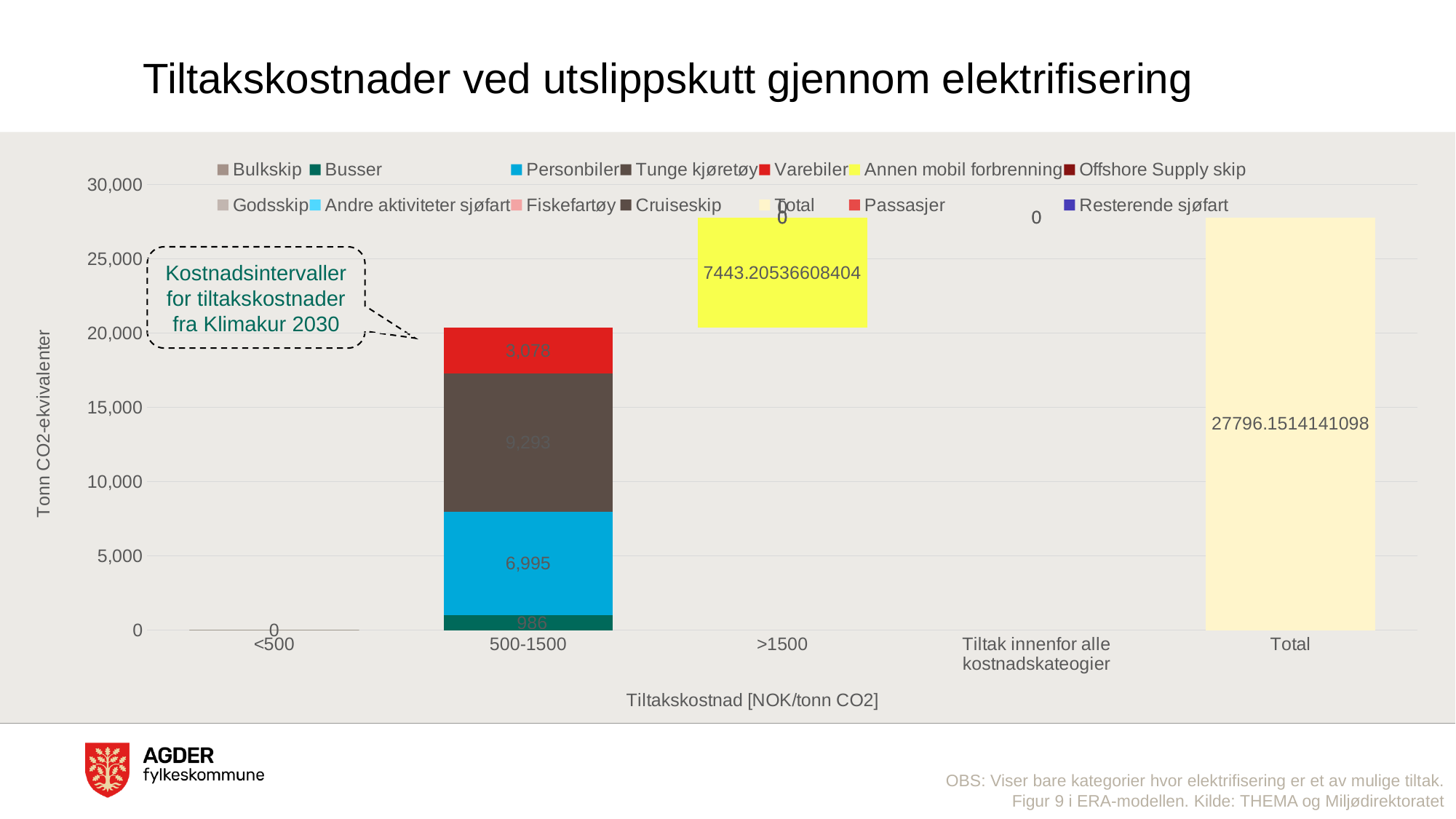
What is the total of the stacked bar for the 500-1500 category? 20,352 What kind of chart is shown on the slide? Stacked bar chart What is the value shown for the Total category? 27796.1514141098 What is the value for Tunge kjøretøy in the 500-1500 category? 9,293 How many categories are shown on the x axis of the chart? 5 What is the difference between Tunge kjøretøy and Personbiler in the 500-1500 category? 2,298 What is the title of the y axis? Tonn CO2-ekvivalenter Which segment is the largest in the 500-1500 stacked bar? Tunge kjøretøy What is the value for Annen mobil forbrenning in the >1500 category? 7443.20536608404 What is the value for Busser in the 500-1500 category? 986 What is the value for Personbiler in the 500-1500 category? 6,995 How many series does the chart legend list? 14